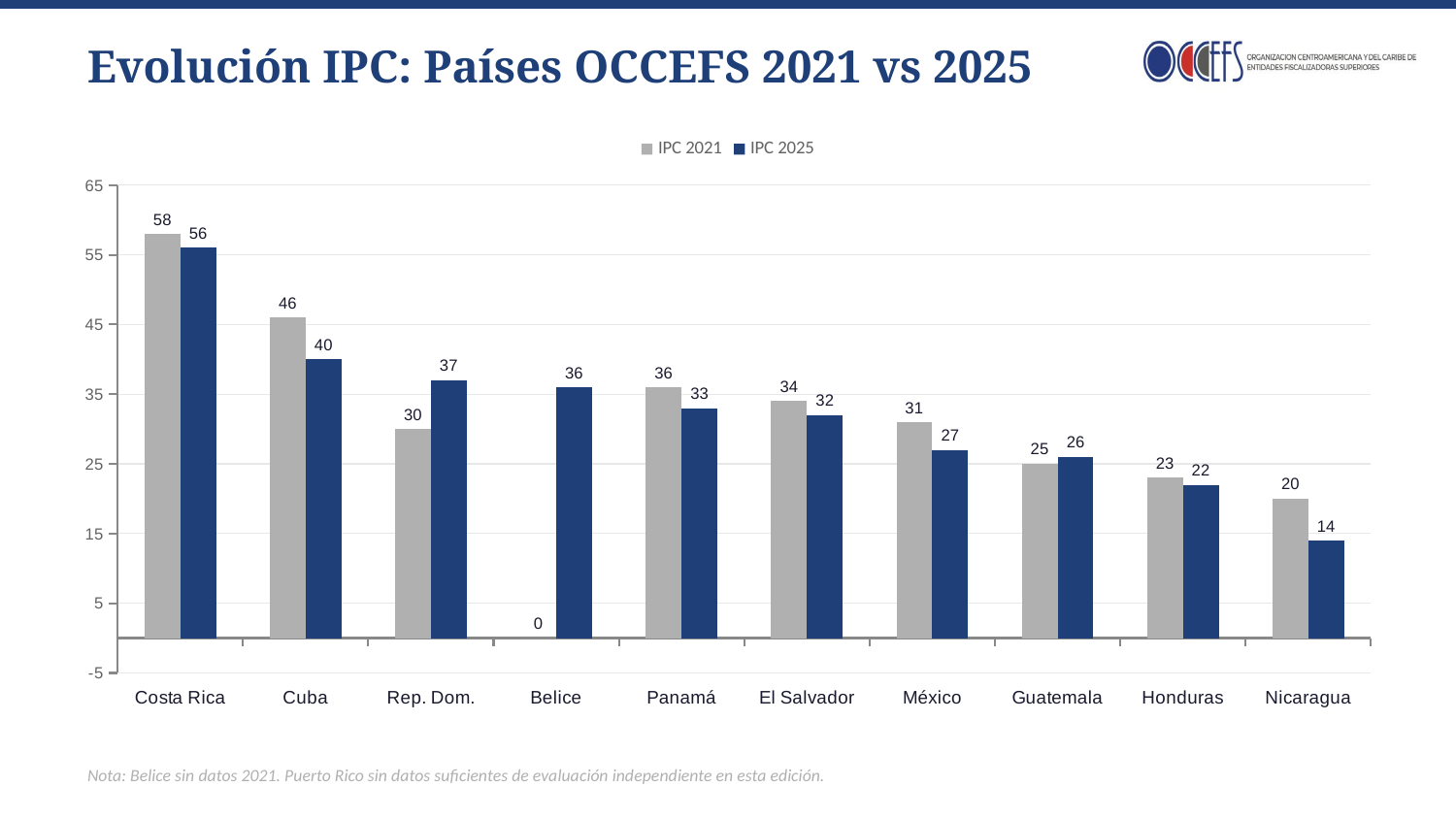
Is the IPC 2025 value for Panamá greater or less than 25? greater What is the IPC 2025 value for Cuba? 40 How many countries are shown on the x axis? 10 How many series does the legend list? 2 Which is larger for Rep. Dom., the IPC 2021 value or the IPC 2025 value? IPC 2025 Do the IPC 2021 values generally rise or fall from Costa Rica to Nicaragua? Fall What is the difference between the IPC 2021 and IPC 2025 values for Cuba? 6 Which country has the highest IPC 2025 value? Costa Rica What is the title of the chart? Evolución IPC: Países OCCEFS 2021 vs 2025 What kind of chart is shown on the slide? Bar chart Which country has the lowest IPC 2025 value? Nicaragua What is the IPC 2021 value for El Salvador? 34